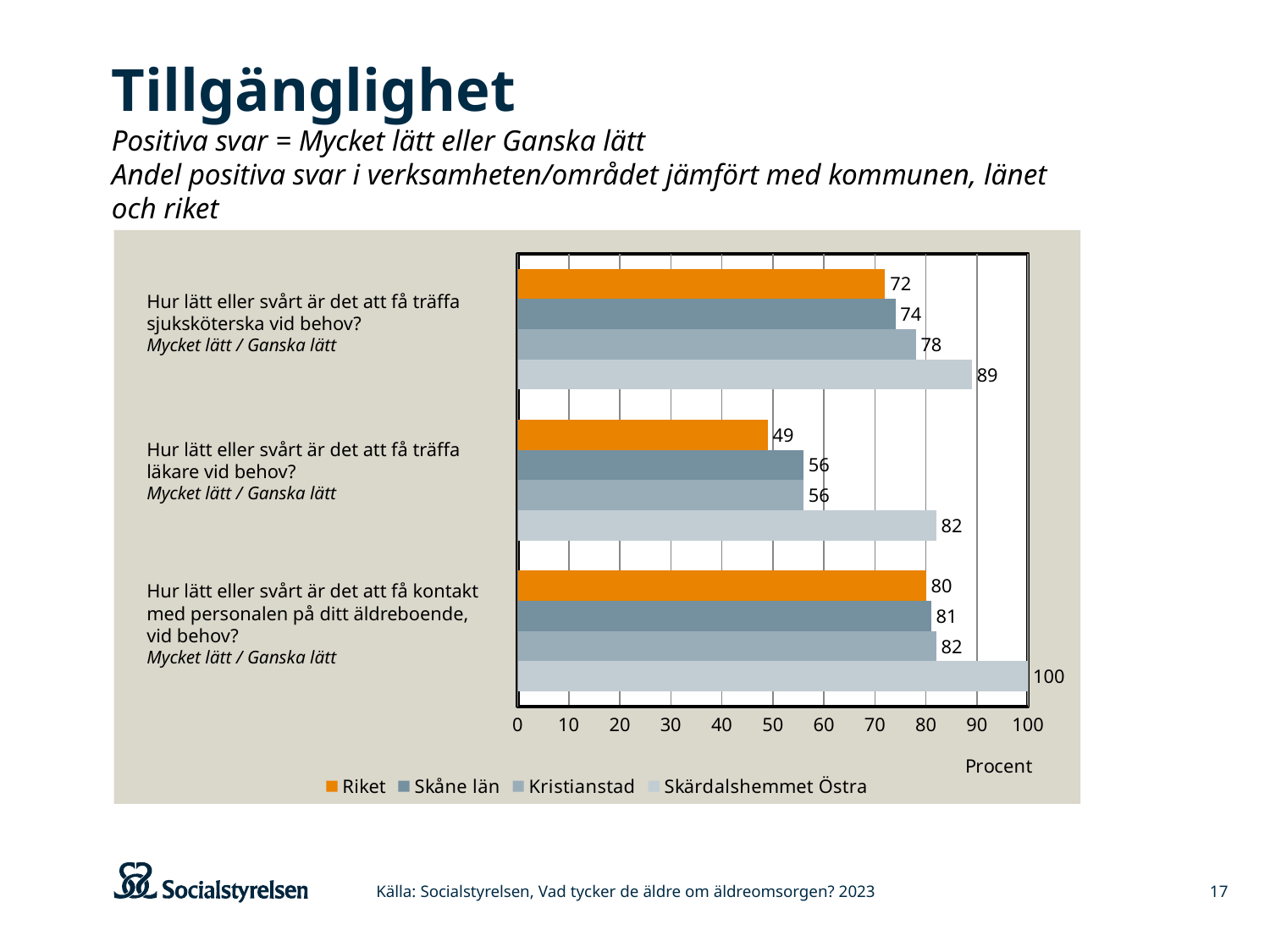
Which is larger: the Riket value for meeting a nurse when needed or the Riket value for meeting a doctor when needed? Meeting a nurse when needed (72) What is the value for Skåne län on the question about meeting a doctor when needed? 56 What is the value for Riket on the question about meeting a doctor when needed ("Hur lätt eller svårt är det att få träffa läkare vid behov?")? 49 How many series does the legend list? 4 How many questions (categories) are shown on the chart? 3 What is the value for Kristianstad on the question about meeting a nurse when needed ("Hur lätt eller svårt är det att få träffa sjuksköterska vid behov?")? 78 Which series has the highest value on the question about meeting a nurse when needed? Skärdalshemmet Östra What is the value for Skärdalshemmet Östra on the question about getting in touch with staff at the care home ("Hur lätt eller svårt är det att få kontakt med personalen på ditt äldreboende, vid behov?")? 100 What kind of chart is shown on the slide? Bar chart What is the difference between Skärdalshemmet Östra and Kristianstad on the question about meeting a nurse when needed? 11 What is the difference between Skärdalshemmet Östra and Riket on the question about meeting a doctor when needed? 33 Which series has the lowest value on the question about meeting a doctor when needed? Riket